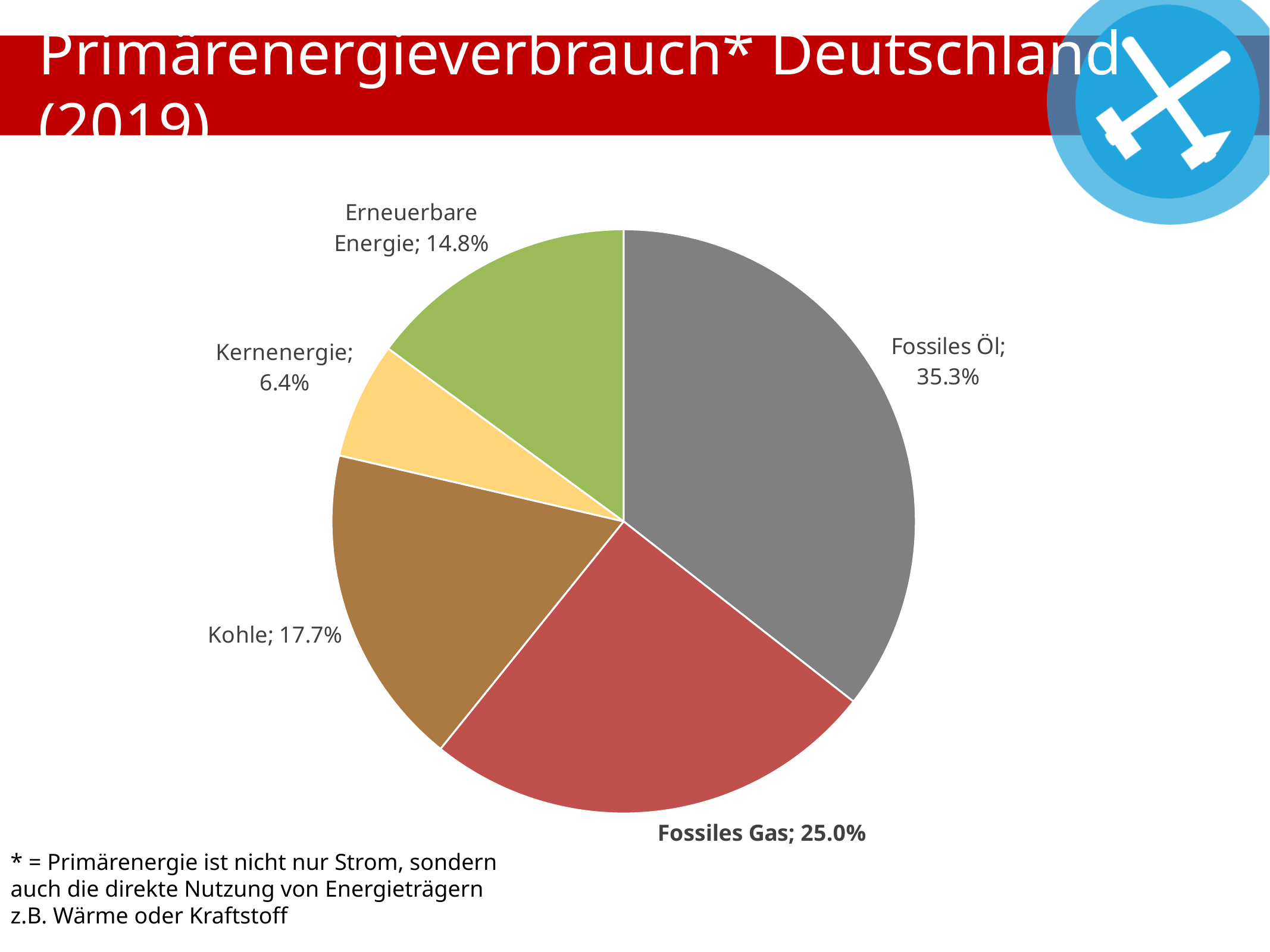
What type of chart is shown on the slide? Pie chart What percentage is shown for Erneuerbare Energie? 14.8% Which category has the largest slice of the pie? Fossiles Öl What share of primary energy consumption does Fossiles Öl account for? 35.3% What is the combined share of Fossiles Öl and Fossiles Gas? 60.3% Which category has the smallest slice of the pie? Kernenergie What is the value for Kohle? 17.7% How many categories are shown in the pie chart? 5 What is the difference in percentage points between Fossiles Öl and Fossiles Gas? 10.3 What is the value shown for Kernenergie? 6.4% What colour is the Fossiles Gas slice? Red Which is larger, Kohle or Erneuerbare Energie? Kohle